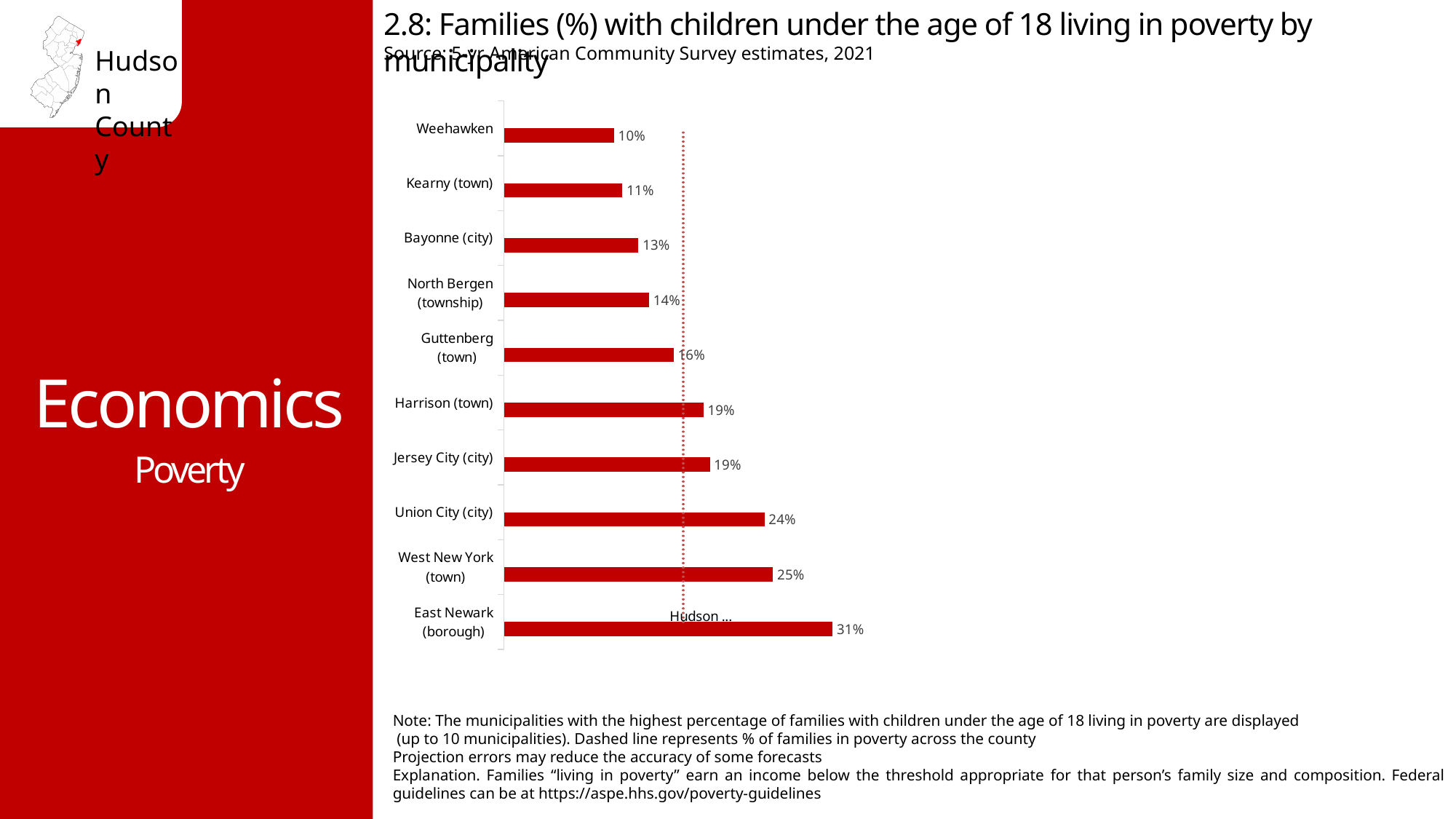
How many municipalities are shown on the chart? 10 What is the difference between the values for Union City (city) and Bayonne (city)? 11% What is the difference between the values for East Newark (borough) and West New York (town)? 6% What is the value shown for Weehawken? 10% Which has a higher value, Harrison (town) or North Bergen (township)? Harrison (town) Which municipality has the highest percentage of families with children under 18 living in poverty? East Newark (borough) What is the value shown for Union City (city)? 24% According to the note, what does the dashed line on the chart represent? % of families in poverty across the county What percentage of families with children under 18 are living in poverty in East Newark (borough)? 31% What is the value shown for Guttenberg (town)? 16% What kind of chart is shown on the slide? Bar chart Which municipality has the lowest percentage shown on the chart? Weehawken